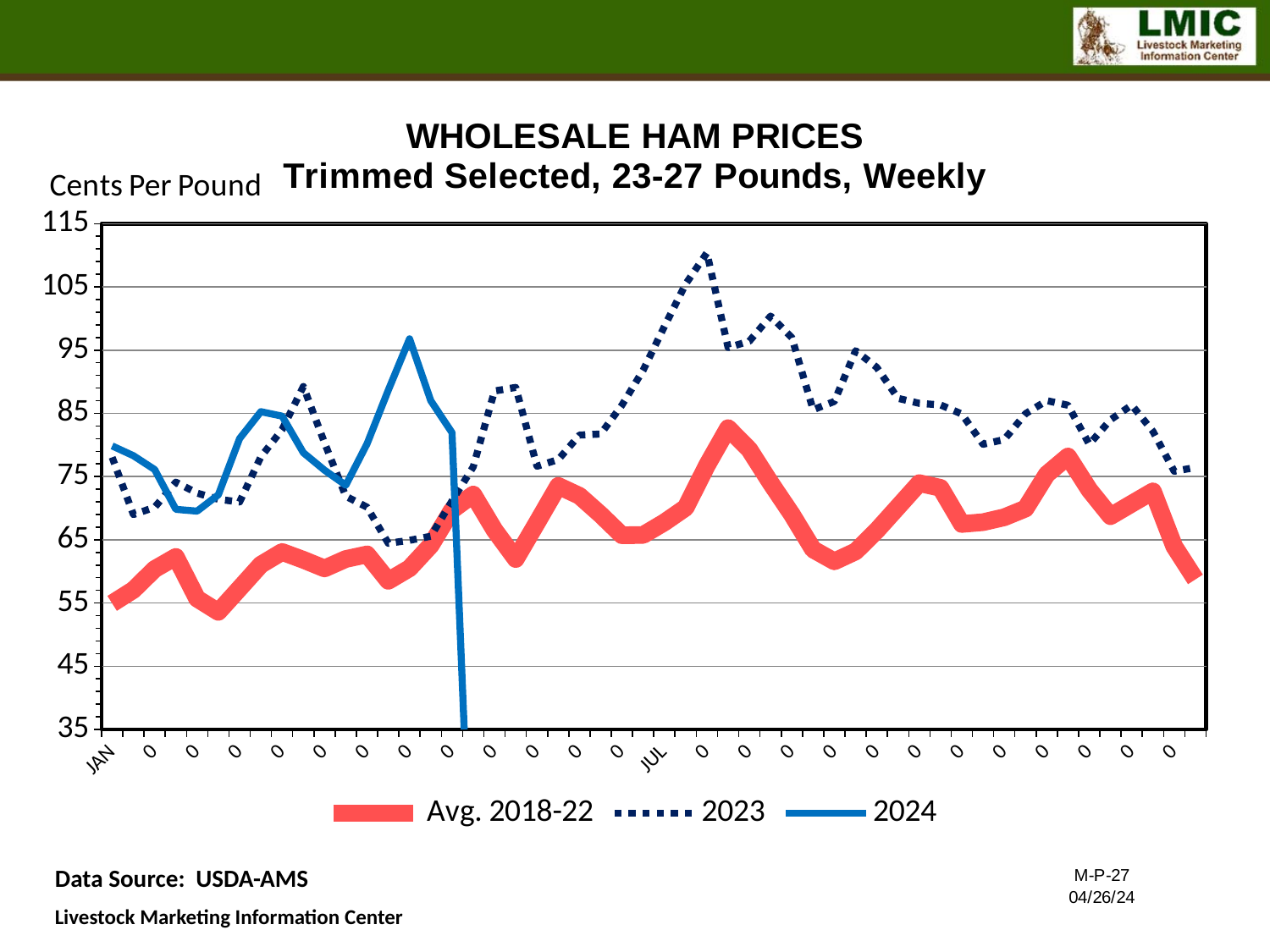
Is the highest value of the Avg. 2018-22 series greater or less than 95? less Does the Avg. 2018-22 series generally rise or fall from JAN to JUL? rise Is the peak value of the 2023 series greater or less than 105? greater Which series reaches the highest value on the chart? 2023 What unit is shown on the y axis of the chart? Cents Per Pound Which series has the lowest value at JAN? Avg. 2018-22 What are the three series listed in the legend? Avg. 2018-22, 2023, 2024 Is the Avg. 2018-22 value at JUL greater or less than 75? less How many series does the legend list? 3 What kind of chart is shown on the slide? line chart At JUL, which is larger: the 2023 value or the Avg. 2018-22 value? 2023